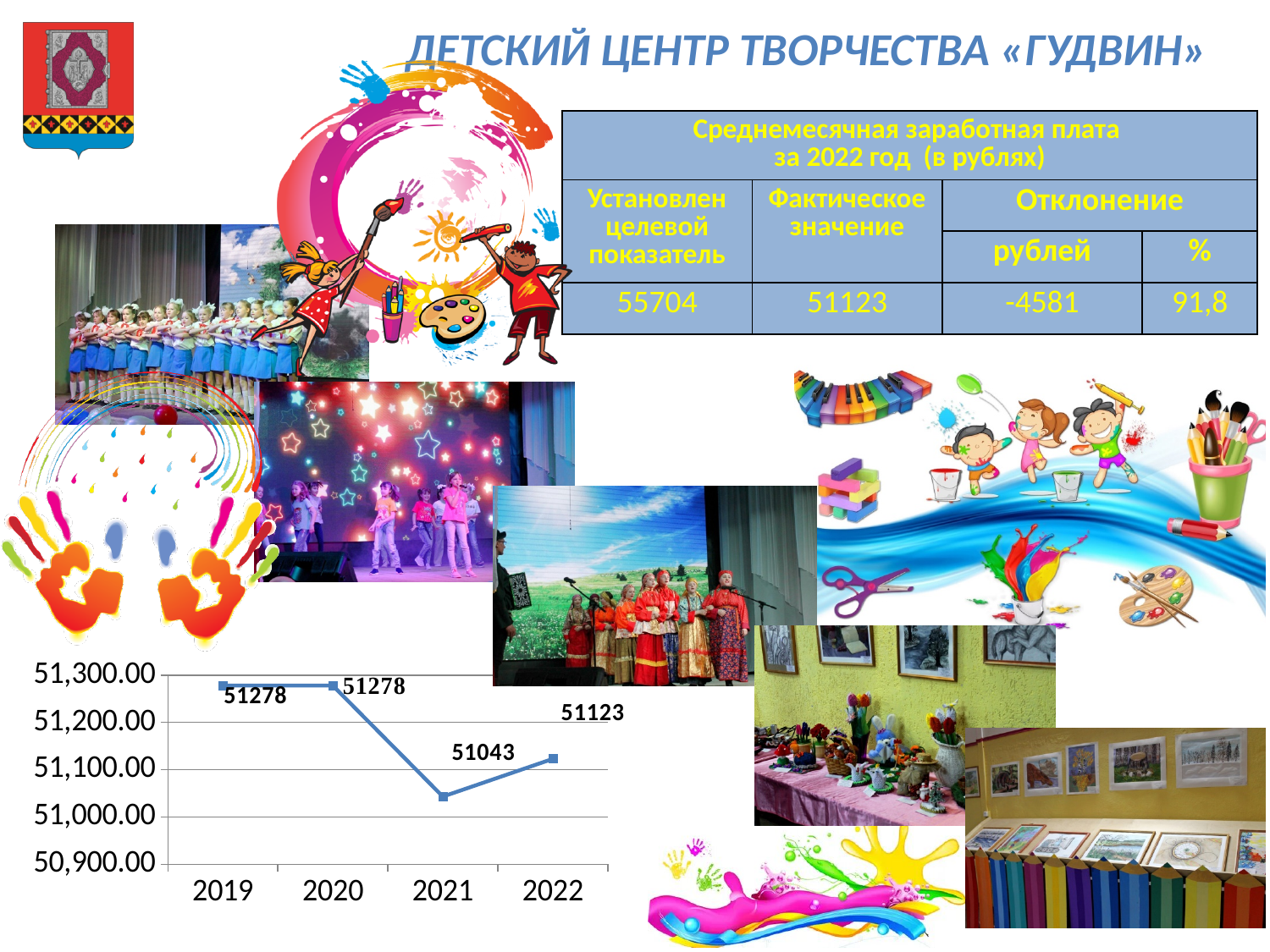
What is the difference between the values for 2022 and 2021 in the line chart? 80 What is the value plotted for 2019 in the line chart? 51278 In the line chart, is the value for 2022 larger or smaller than the value for 2020? smaller What is the value plotted for 2022 in the line chart? 51123 What is the value plotted for 2021 in the line chart? 51043 Which year has the lowest value in the line chart? 2021 Does the line chart rise or fall from 2020 to 2021? fall In the line chart, is the value for 2021 greater or less than 51,100.00? less What is the difference between the values for 2020 and 2021 in the line chart? 235 Does the line chart rise or fall from 2021 to 2022? rise What type of chart is shown at the bottom left of the slide? line chart How many data points are plotted in the line chart? 4